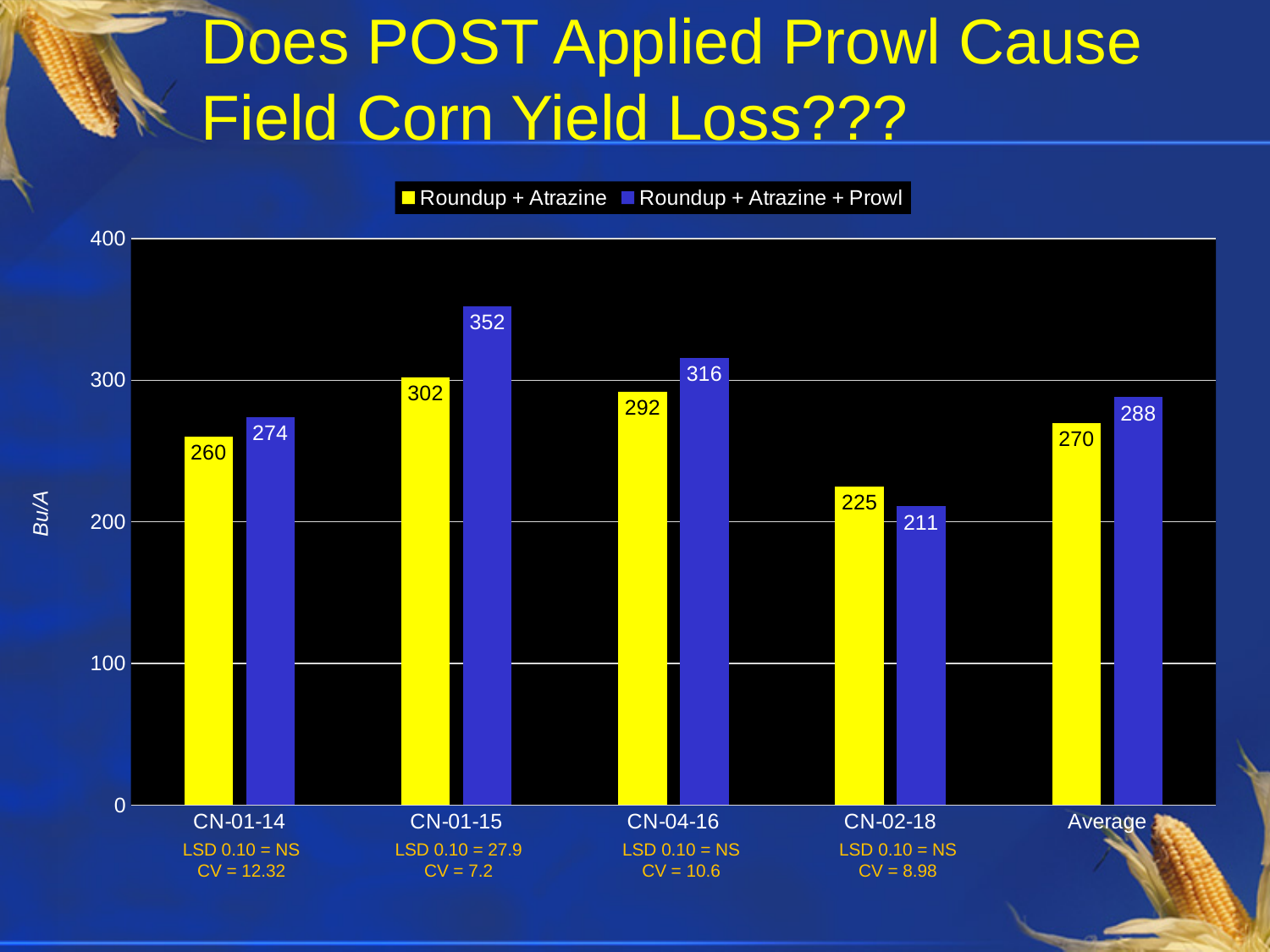
What is the difference between the Roundup + Atrazine + Prowl and Roundup + Atrazine values at CN-01-15? 50 What is the value for Roundup + Atrazine at CN-02-18? 225 Which is larger at CN-02-18: Roundup + Atrazine or Roundup + Atrazine + Prowl? Roundup + Atrazine Which category has the highest value for Roundup + Atrazine? CN-01-15 What is the Average value for Roundup + Atrazine + Prowl? 288 How many series does the legend list? 2 Which category has the lowest value for Roundup + Atrazine + Prowl? CN-02-18 What is the value for Roundup + Atrazine + Prowl at CN-01-15? 352 What kind of chart is shown on the slide? bar chart Is the value for Roundup + Atrazine + Prowl at CN-04-16 greater or less than 300? greater What is the label on the y axis? Bu/A How many categories are shown on the x axis? 5